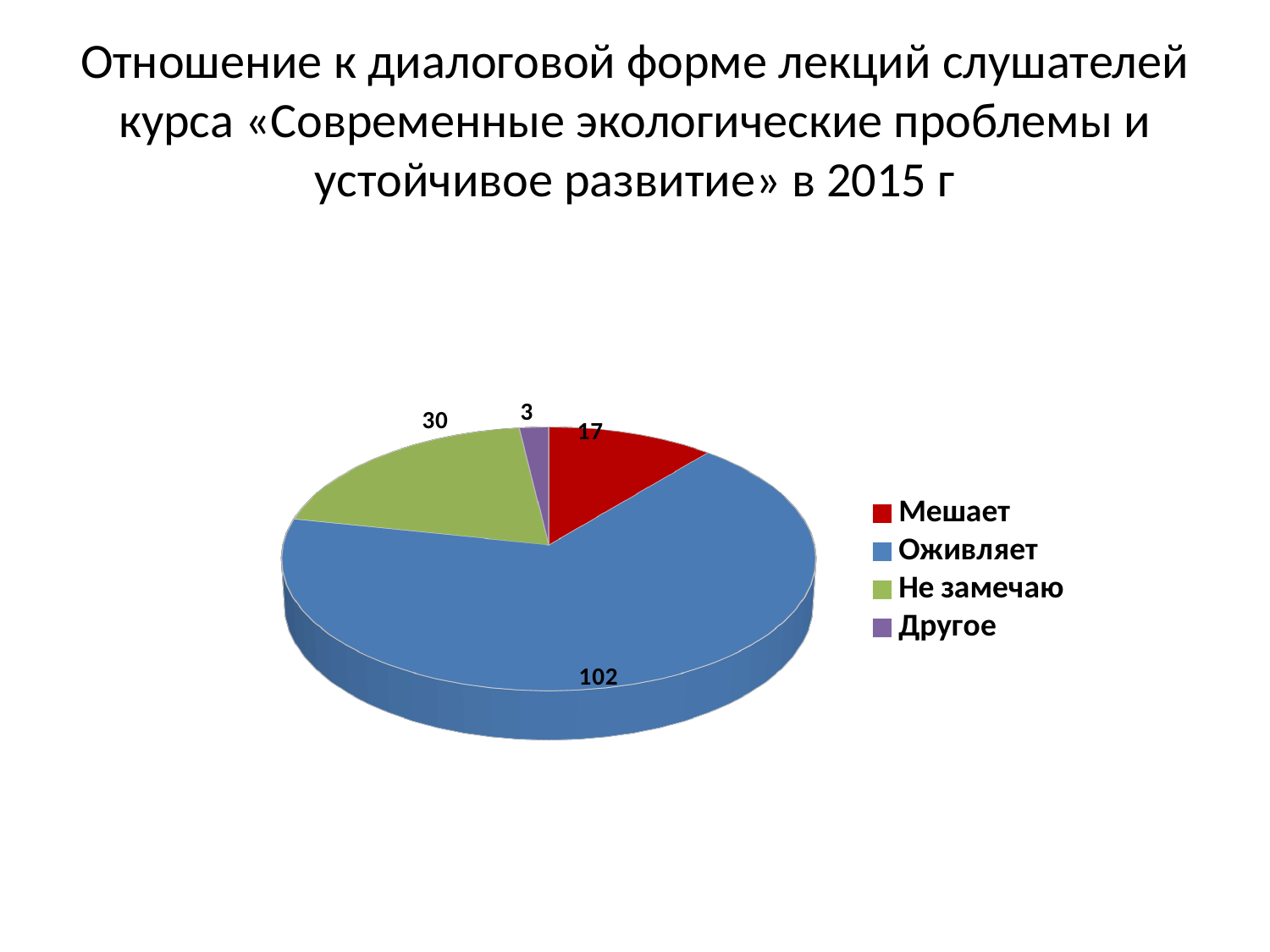
What value is shown for the "Другое" slice? 3 Which is larger, the value for "Мешает" or the value for "Не замечаю"? Не замечаю What value is shown for the "Оживляет" slice? 102 What value is shown for the "Мешает" slice? 17 What is the total of all the values shown in the pie chart? 152 What value is shown for the "Не замечаю" slice? 30 What is the difference between the values for "Оживляет" and "Не замечаю"? 72 How many categories does the pie chart show? 4 Which category has the smallest slice of the pie? Другое What kind of chart is shown on the slide? Pie chart What colour is the "Оживляет" slice in the pie chart? Blue Which category has the largest slice of the pie? Оживляет